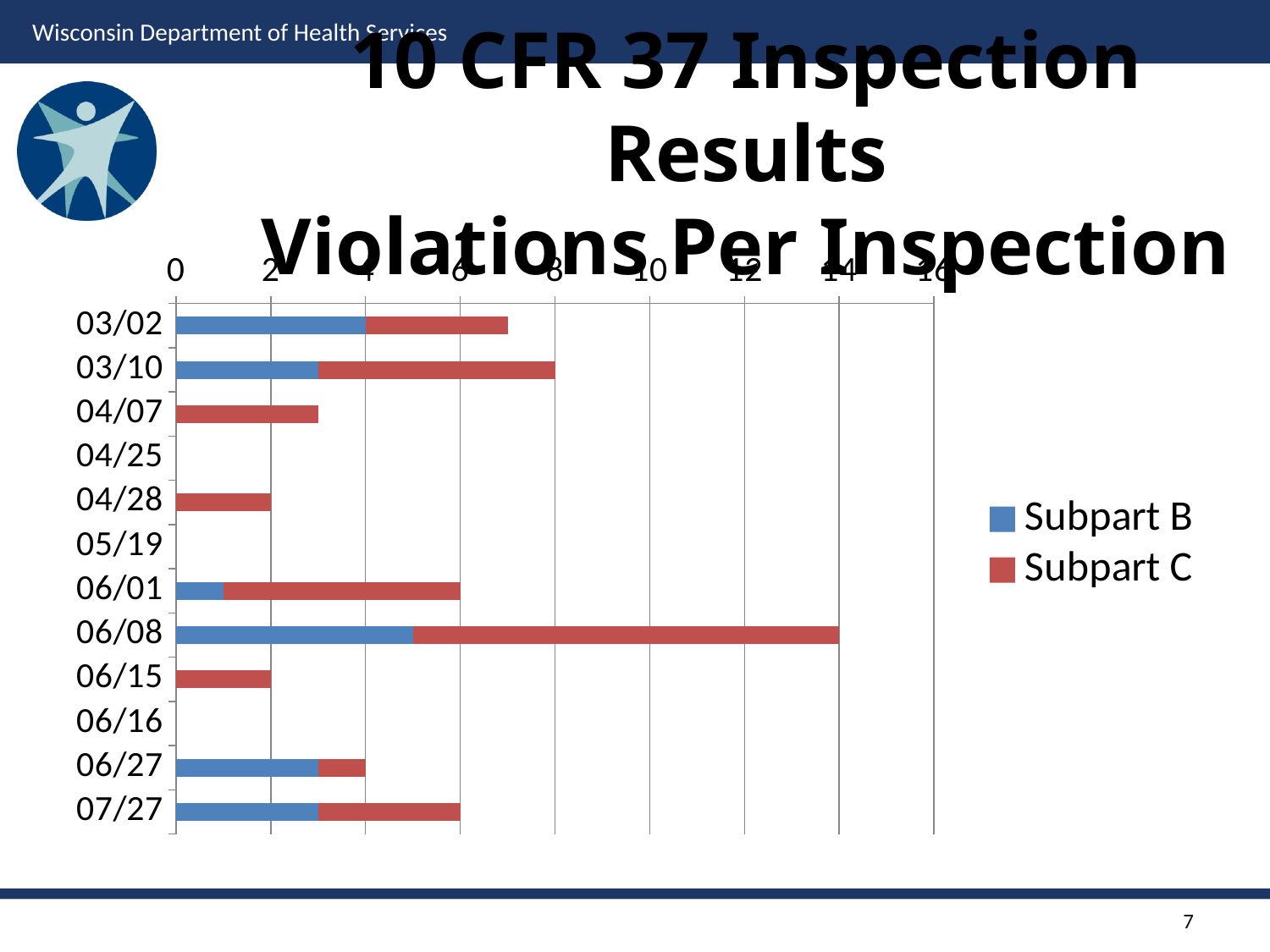
Is the total number of violations for the 03/02 inspection greater or less than 6? greater Is the total number of violations for the 04/07 inspection greater or less than 2? greater What is the title of the chart? Violations Per Inspection How many series does the chart legend list? 2 Which inspection date has the highest total number of violations? 06/08 Which colour represents Subpart C in the chart? red Which inspection has more total violations, 06/08 or 06/01? 06/08 What kind of chart is shown on the slide? bar chart What is the total number of violations for the 06/08 inspection? 14 What is the total number of violations for the 03/10 inspection? 8 How many Subpart C violations were found in the 04/28 inspection? 2 How many inspection dates are listed on the vertical axis of the chart? 12